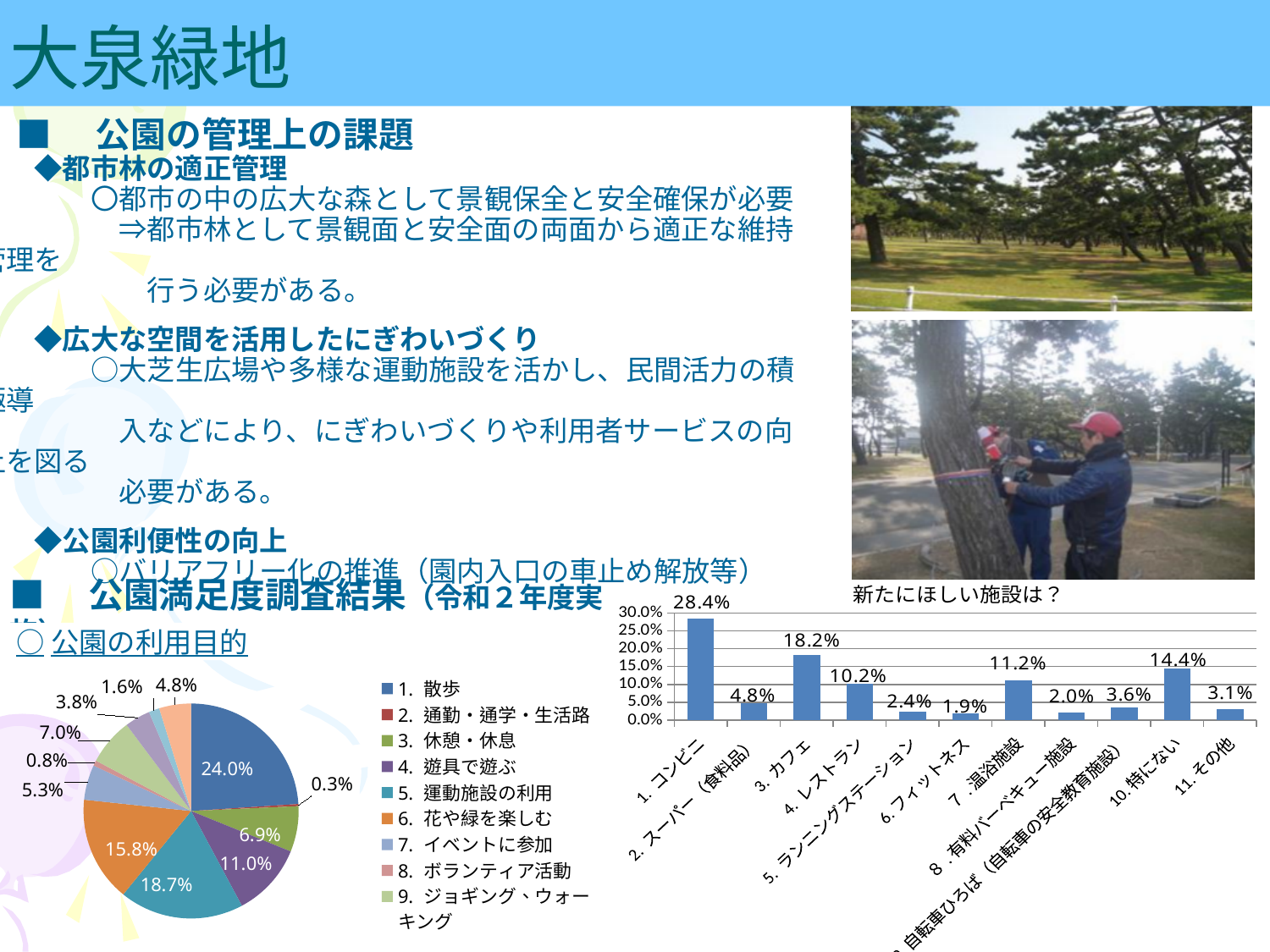
In the pie chart titled 公園の利用目的, which slice is the largest? 1. 散歩 In the bar chart titled 新たにほしい施設は？, what is the value for 10. 特にない? 14.4% In the bar chart titled 新たにほしい施設は？, which category has the highest value? 1. コンビニ In the bar chart titled 新たにほしい施設は？, what is the value for 1. コンビニ? 28.4% In the bar chart titled 新たにほしい施設は？, which category has the lowest value? 6. フィットネス In the bar chart titled 新たにほしい施設は？, how many categories are shown? 11 What kind of chart is the chart titled 公園の利用目的? pie chart In the bar chart titled 新たにほしい施設は？, what is the value for 3. カフェ? 18.2% In the bar chart titled 新たにほしい施設は？, what is the difference between the values for 1. コンビニ and 3. カフェ? 10.2% In the pie chart titled 公園の利用目的, what is the share for 1. 散歩? 24.0% In the bar chart titled 新たにほしい施設は？, which is larger: the value for 7. 温浴施設 or the value for 4. レストラン? 7. 温浴施設 What kind of chart is the chart titled 新たにほしい施設は？? bar chart